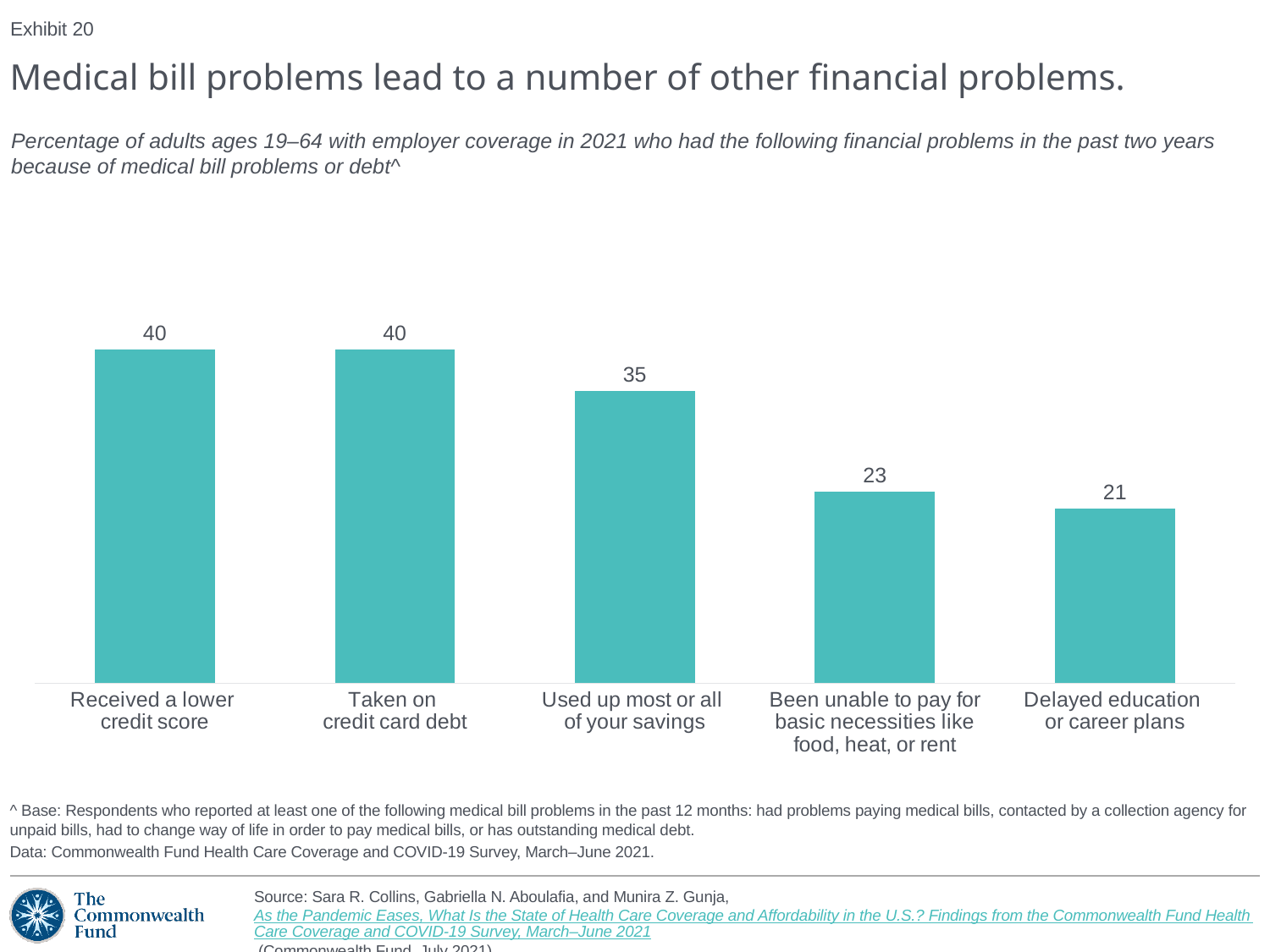
What is the value for "Used up most or all of your savings"? 35 Which is larger: the value for "Been unable to pay for basic necessities like food, heat, or rent" or the value for "Delayed education or career plans"? Been unable to pay for basic necessities like food, heat, or rent How many categories are shown on the chart? 5 Which two categories share the same value of 40? Received a lower credit score; Taken on credit card debt What is the value for "Been unable to pay for basic necessities like food, heat, or rent"? 23 What is the difference between the value for "Taken on credit card debt" and the value for "Used up most or all of your savings"? 5 Do the values rise or fall moving from left to right across the chart? Fall What is the difference between the value for "Received a lower credit score" and the value for "Delayed education or career plans"? 19 Which financial problem has the lowest value on the chart? Delayed education or career plans What percentage of adults received a lower credit score because of medical bill problems or debt? 40 What is the value for "Delayed education or career plans"? 21 What kind of chart is shown on the slide? Bar chart